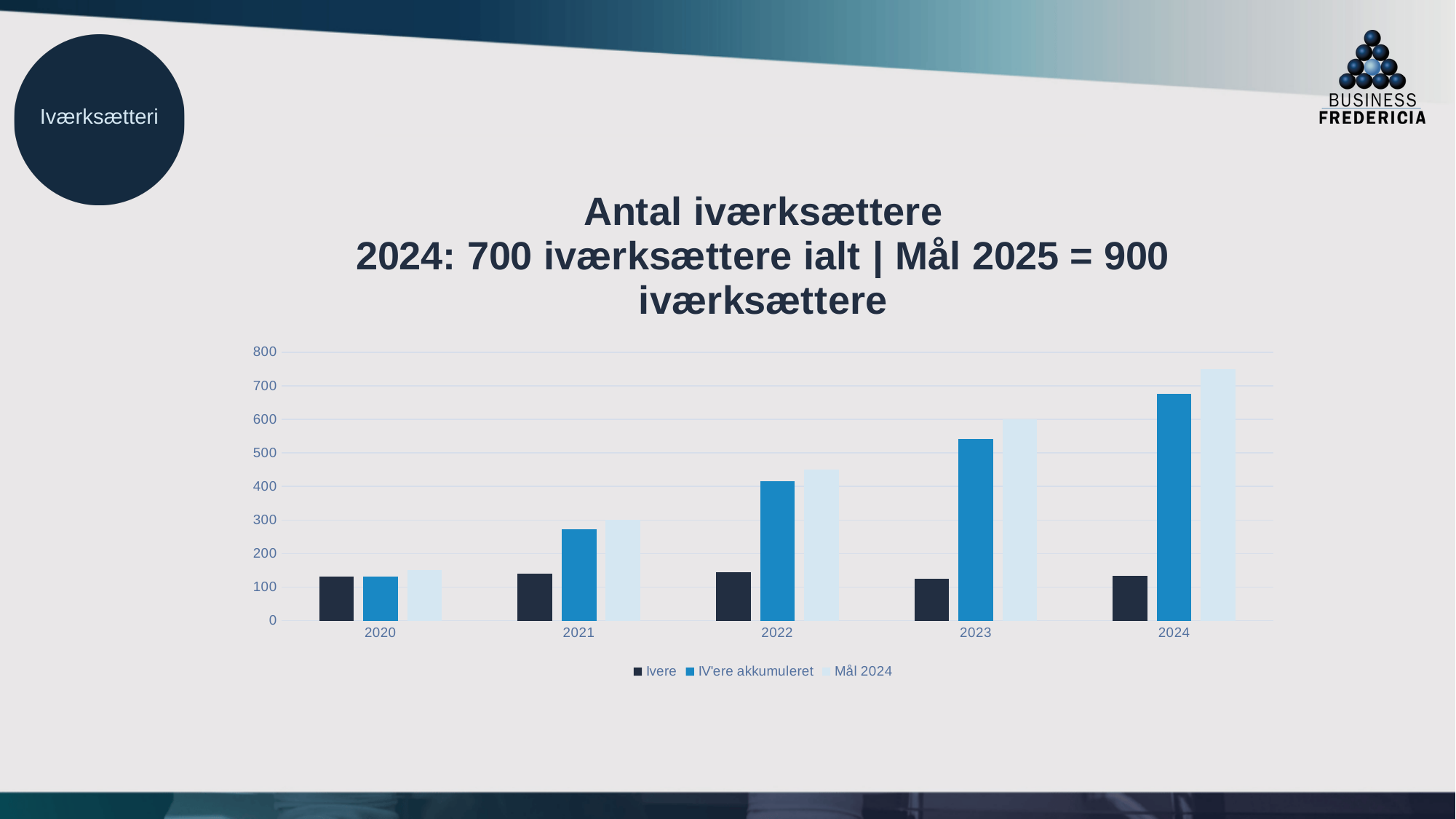
Which year has the highest value for IV'ere akkumuleret? 2024 Is the value for Ivere in 2023 greater or less than 200? less What is the first line of the chart title? Antal iværksættere How many series does the legend list? 3 Is the value for IV'ere akkumuleret in 2024 greater or less than 600? greater How many years are shown on the x axis? 5 Is the value for IV'ere akkumuleret in 2021 greater or less than 300? less Which is larger in 2023: IV'ere akkumuleret or Mål 2024? Mål 2024 What kind of chart is shown on the slide? bar chart Which year has the lowest value for Mål 2024? 2020 Do the values for IV'ere akkumuleret rise or fall from 2020 to 2024? rise